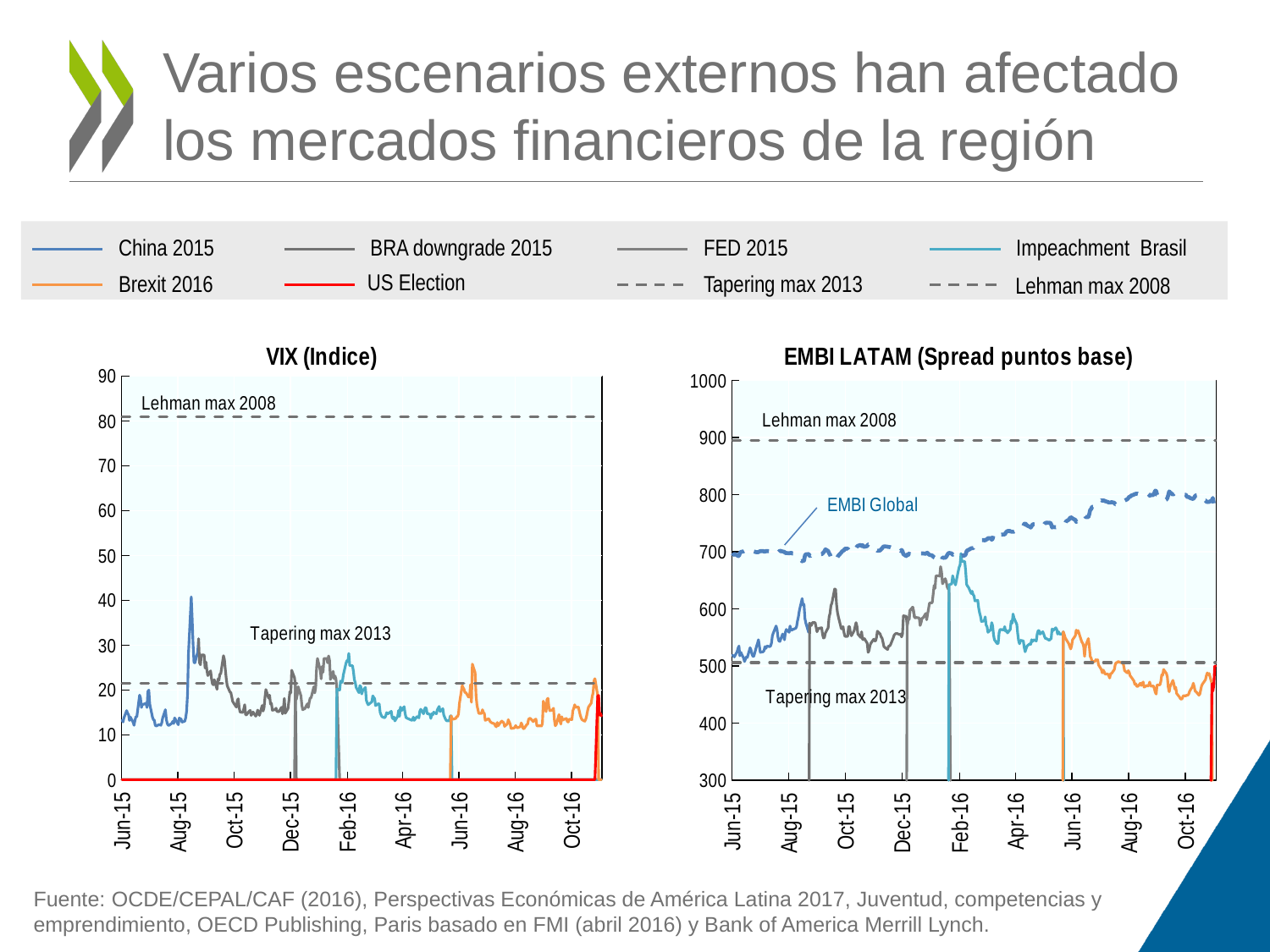
In the VIX (Indice) chart, which reference line is higher: Lehman max 2008 or Tapering max 2013? Lehman max 2008 In the EMBI LATAM chart, is the Lehman max 2008 dashed line greater or less than 800? greater In the EMBI LATAM chart, is the Tapering max 2013 dashed line greater or less than 600? less What is the highest value shown on the y axis of the VIX (Indice) chart? 90 In the VIX (Indice) chart, is the Lehman max 2008 dashed line greater or less than 70? greater In the EMBI LATAM chart, does the EMBI Global dashed line rise or fall from Jun-15 to Oct-16? rise What is the title of the right-hand chart? EMBI LATAM (Spread puntos base) What kind of chart is the VIX (Indice) chart? line chart How many labelled tick marks are on the x axis of the EMBI LATAM chart? 9 How many series does the shared legend list? 8